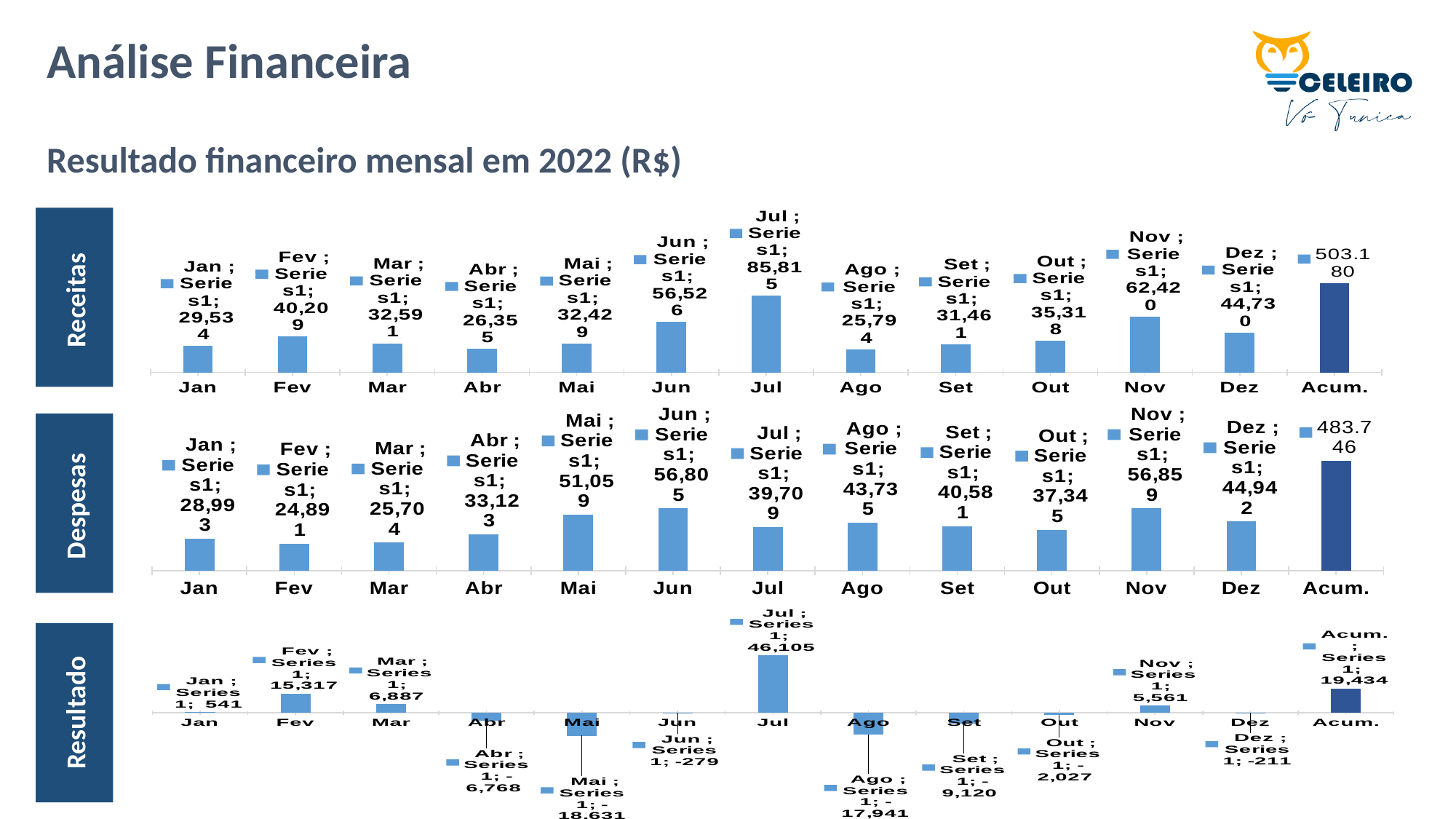
In the Resultado chart, what is the difference between the values for Jul and Fev? 30,788 In the Despesas chart, what is the value for Mai? 51,059 In the Resultado chart, which month has the lowest value? Mai In the Receitas chart, which month has the highest value? Jul How many categories are shown on the x axis of the Despesas chart? 13 In the Receitas chart, what is the value for Jul? 85,815 In the Receitas chart, what is the value shown for Acum.? 503.180 In the Despesas chart, which is larger, the value for Abr or the value for Mai? Mai In the Receitas chart, which month has the lowest value? Ago In the Resultado chart, what is the value for Ago? -17,941 In the Receitas chart, what is the difference between the values for Jul and Jun? 29,289 In the Despesas chart, which month has the lowest value? Fev